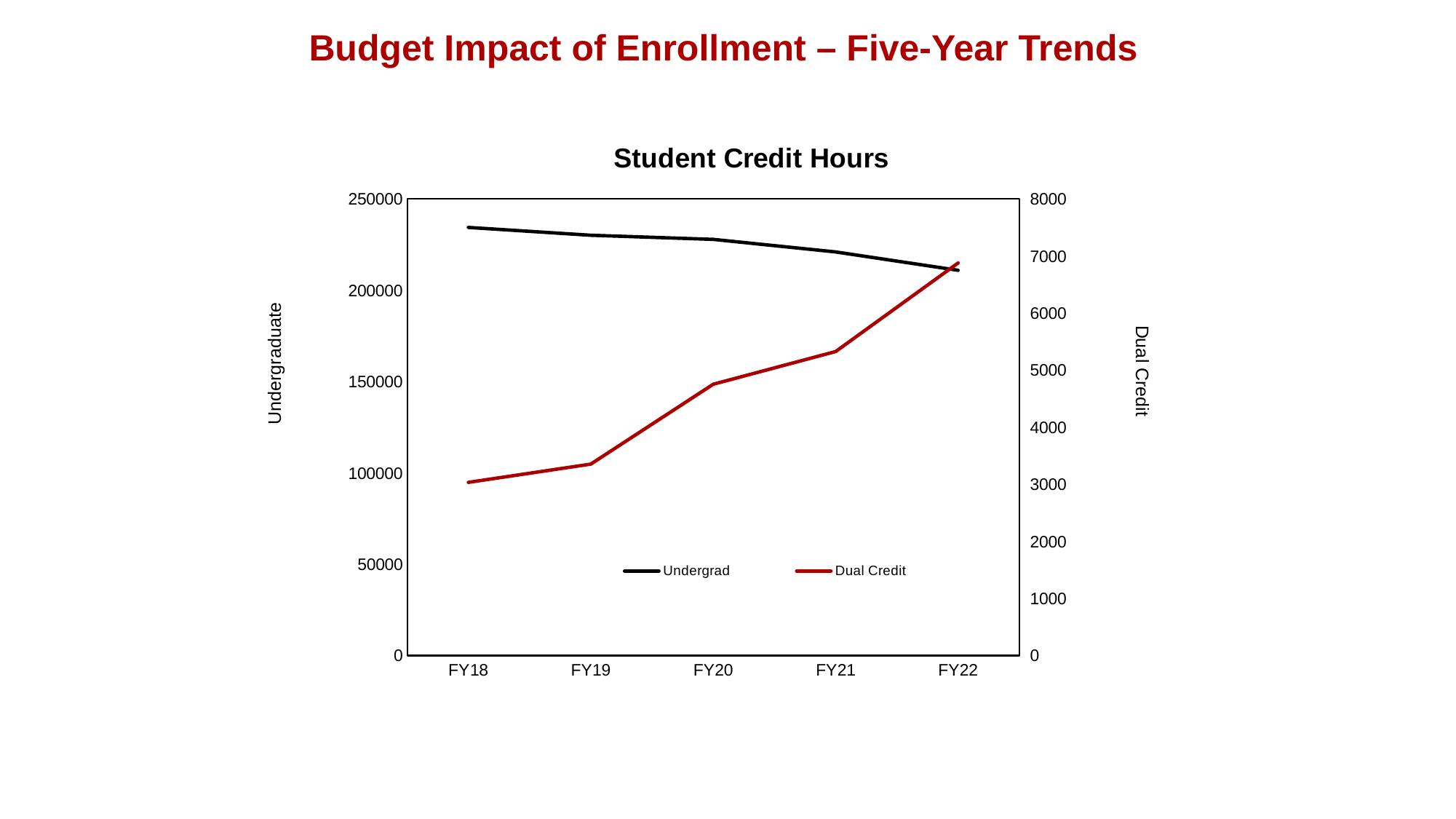
In which fiscal year is the Dual Credit value highest? FY22 Does the Dual Credit series rise or fall from FY18 to FY22? Rise Is the Undergrad value for FY18 greater or less than 200000? greater Is the Dual Credit value for FY22 greater or less than 6000? greater Does the Undergrad series rise or fall from FY18 to FY22? Fall How many series does the legend list? 2 In which fiscal year is the Dual Credit value lowest? FY18 What is the title of the chart? Student Credit Hours Is the Dual Credit value for FY18 greater or less than 4000? less What kind of chart is shown on the slide? Line chart In which fiscal year is the Undergrad value lowest? FY22 How many fiscal years are plotted along the x axis? 5